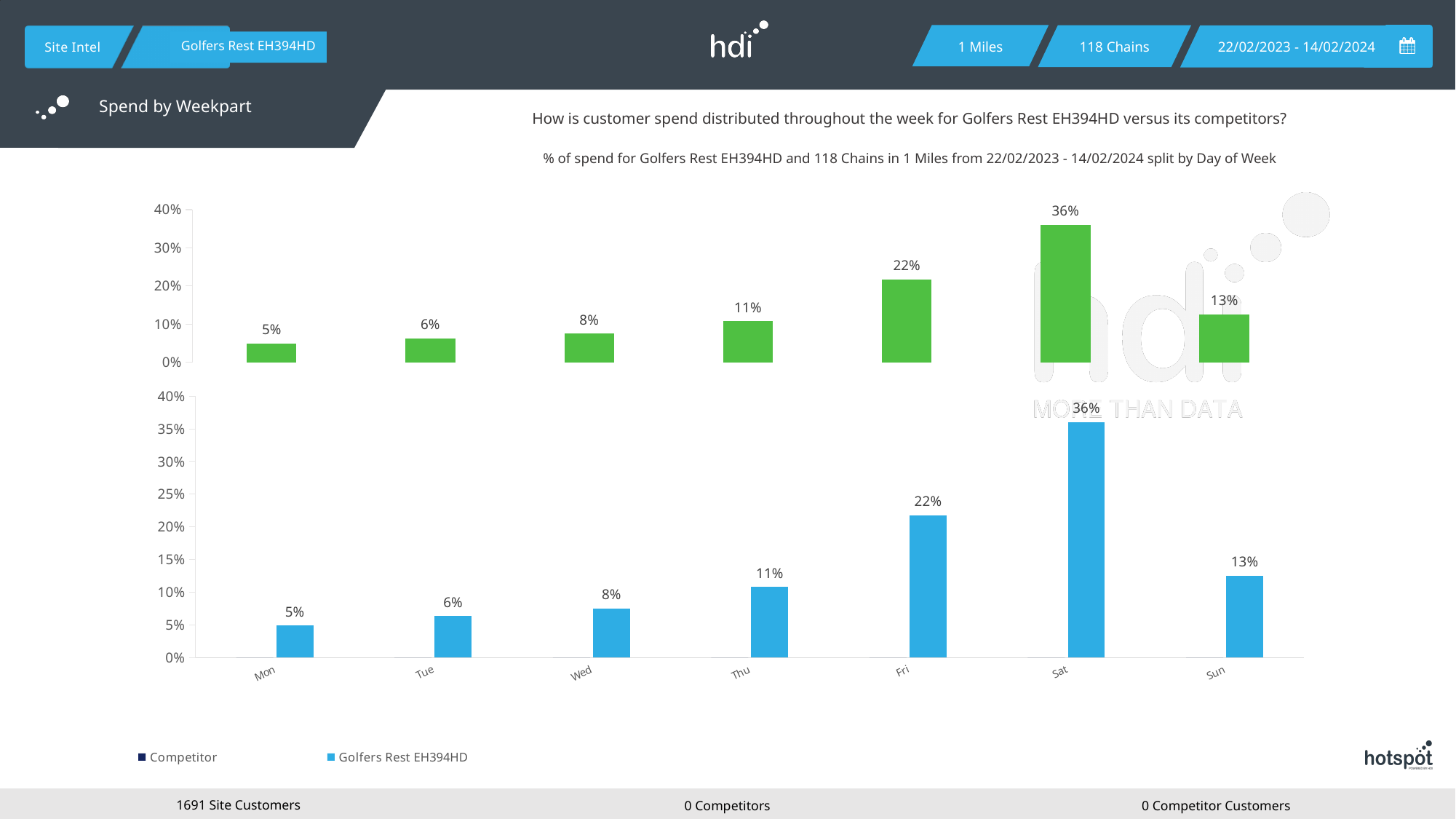
In the lower chart, what is the value for Wed? 8% In the lower chart, do the values rise or fall from Mon to Sat? rise In the lower chart, what is the difference between the values for Sat and Fri? 14% In the lower chart, what is the value for Sun? 13% How many days are shown on the x axis of the lower chart? 7 How many series does the legend list? 2 In the lower chart, which is larger, the value for Thu or the value for Sun? Sun In the lower chart, is the value for Fri greater or less than 20%? greater In the lower chart, which day has the lowest value? Mon In the lower chart, which day has the highest value? Sat What kind of chart is the lower chart? bar chart In the lower chart, what is the value for Sat? 36%